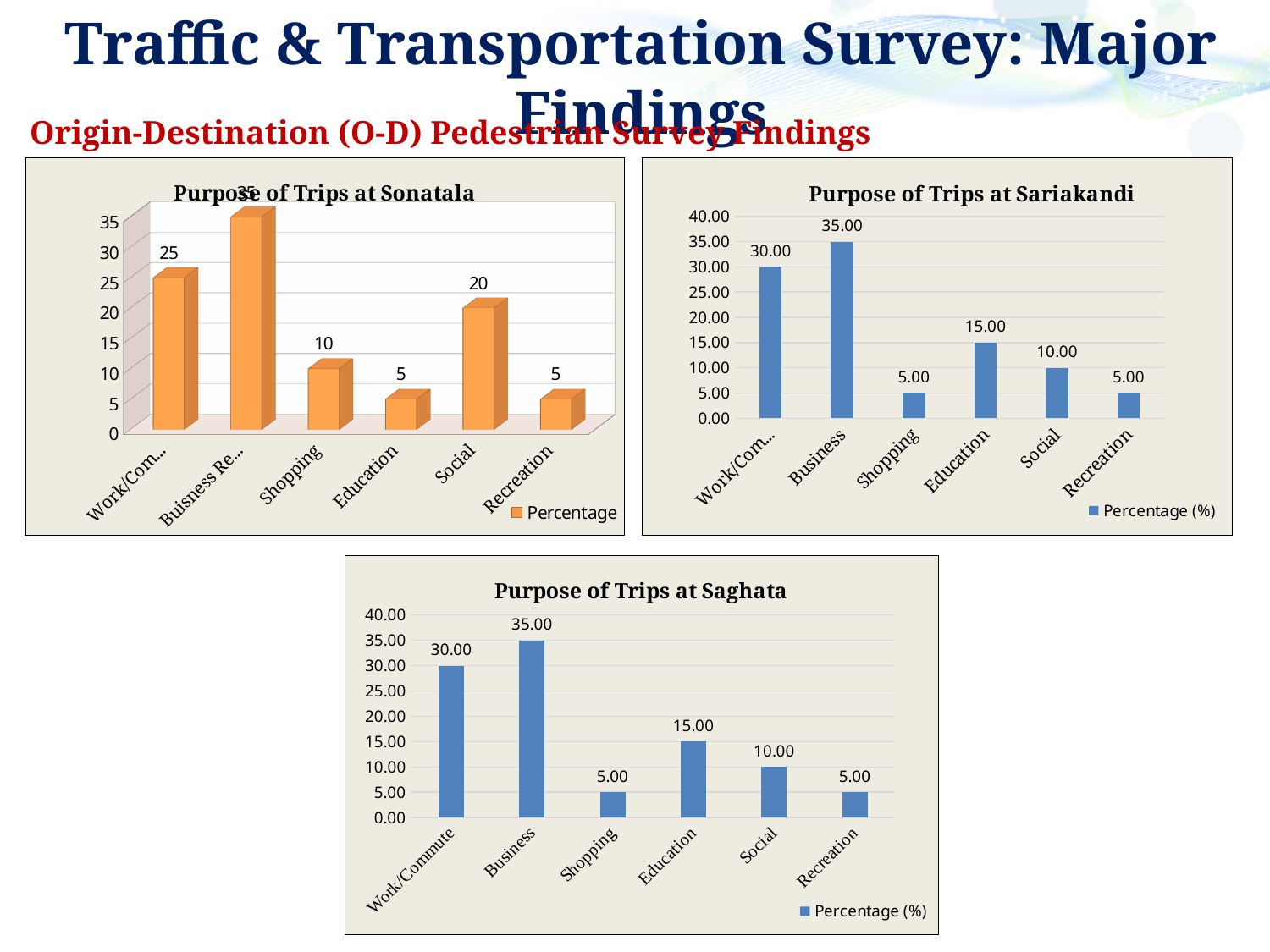
In the 'Purpose of Trips at Sariakandi' chart, what is the difference between the values for Work/Commute and Education? 15.00 How many series does the legend of the 'Purpose of Trips at Sariakandi' chart list? 1 In the 'Purpose of Trips at Sariakandi' chart, which category has the highest value? Business In the 'Purpose of Trips at Saghata' chart, which is larger, Social or Education? Education In the 'Purpose of Trips at Sonatala' chart, what is the value for Shopping? 10 In the 'Purpose of Trips at Sariakandi' chart, what is the value for Business? 35.00 In the 'Purpose of Trips at Sonatala' chart, what is the difference between the values for Social and Education? 15 In the 'Purpose of Trips at Sonatala' chart, which is larger, Shopping or Social? Social What kind of chart is 'Purpose of Trips at Saghata'? Bar chart In the 'Purpose of Trips at Saghata' chart, what is the value for Education? 15.00 In the 'Purpose of Trips at Saghata' chart, how many categories are shown on the x axis? 6 In the 'Purpose of Trips at Sonatala' chart, what is the value for Social? 20